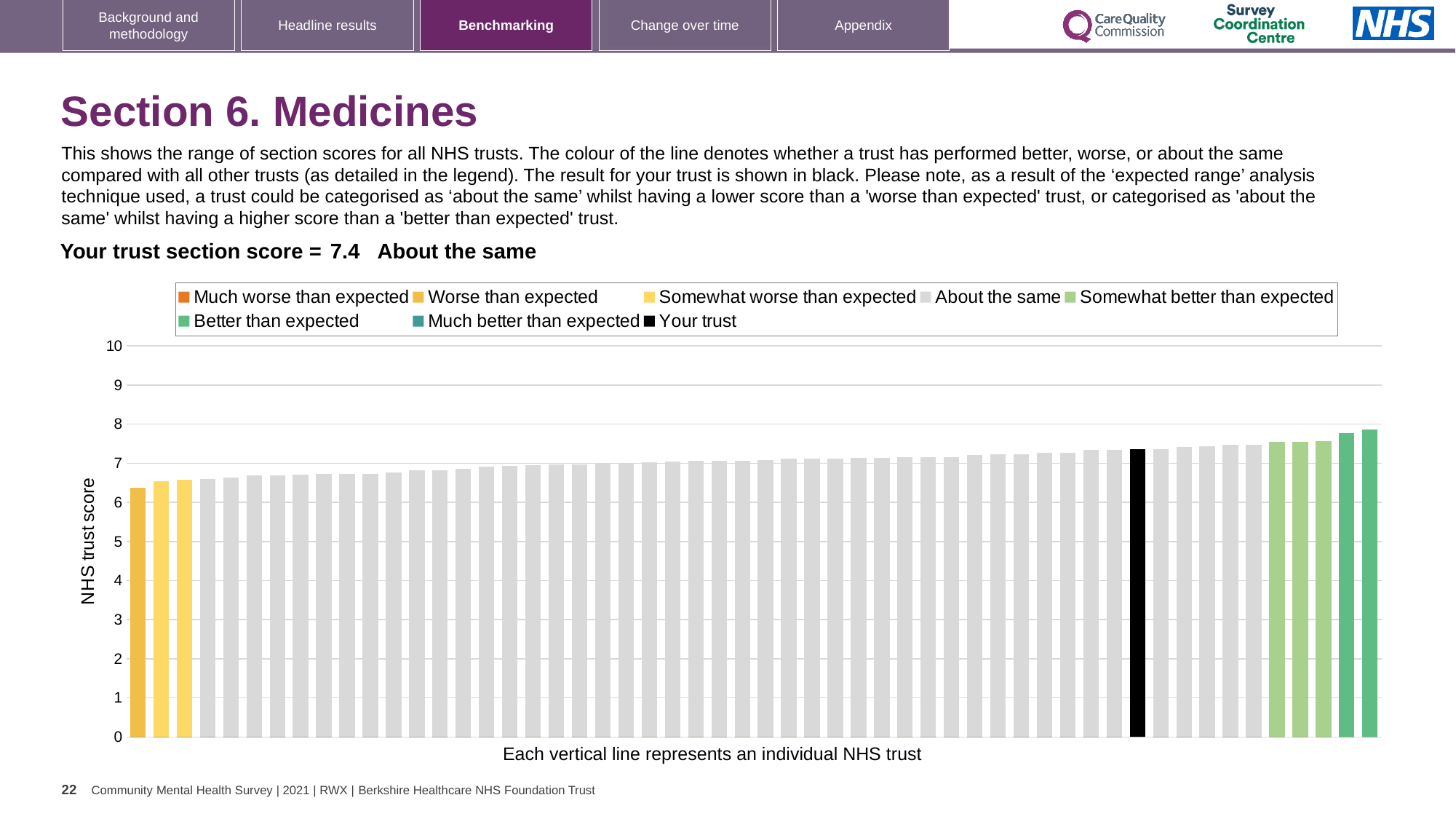
Is the value of the black 'Your trust' bar greater or less than 7? greater What kind of chart is shown on the slide? Bar chart How many bars are coloured as 'Somewhat better than expected' (light green)? 3 How many bars are coloured as 'Better than expected' (darker green)? 2 Is the value of the leftmost (lowest) bar greater or less than 7? less What colour is used for the 'Your trust' bar? Black How many entries does the legend list? 8 Do the bar values rise or fall from left to right along the x axis? Rise What is the label on the vertical axis? NHS trust score Is the value of the rightmost (highest) bar greater or less than 8? less What is the trust's section score for Section 6. Medicines? 7.4 Which category is the trust's section score placed in? About the same